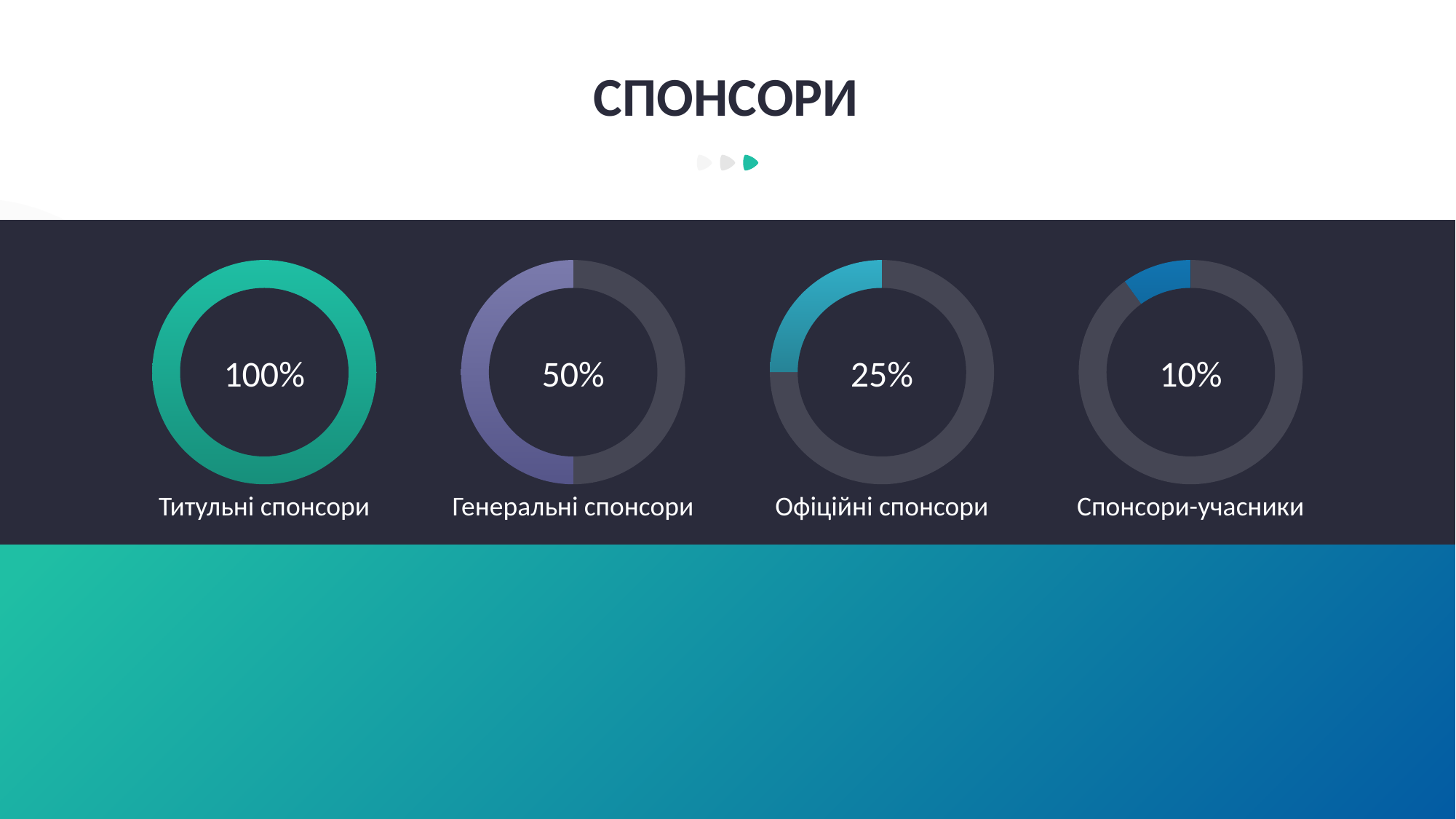
What is the title of the slide containing the four donut charts? СПОНСОРИ How many donut charts are shown on the slide? 4 What is the difference between the values shown in the "Генеральні спонсори" and "Офіційні спонсори" donut charts? 25% Which is larger: the value in the "Офіційні спонсори" donut chart or the value in the "Спонсори-учасники" donut chart? Офіційні спонсори Across the four donut charts on the slide, which category has the highest value? Титульні спонсори What value is shown in the donut chart labelled "Генеральні спонсори"? 50% What value is shown in the donut chart labelled "Титульні спонсори"? 100% Across the four donut charts on the slide, which category has the lowest value? Спонсори-учасники What value is shown in the donut chart labelled "Офіційні спонсори"? 25% What kind of chart is used for each of the four sponsor categories on the slide? Donut chart What value is shown in the donut chart labelled "Спонсори-учасники"? 10% What is the difference between the values shown in the "Титульні спонсори" and "Спонсори-учасники" donut charts? 90%